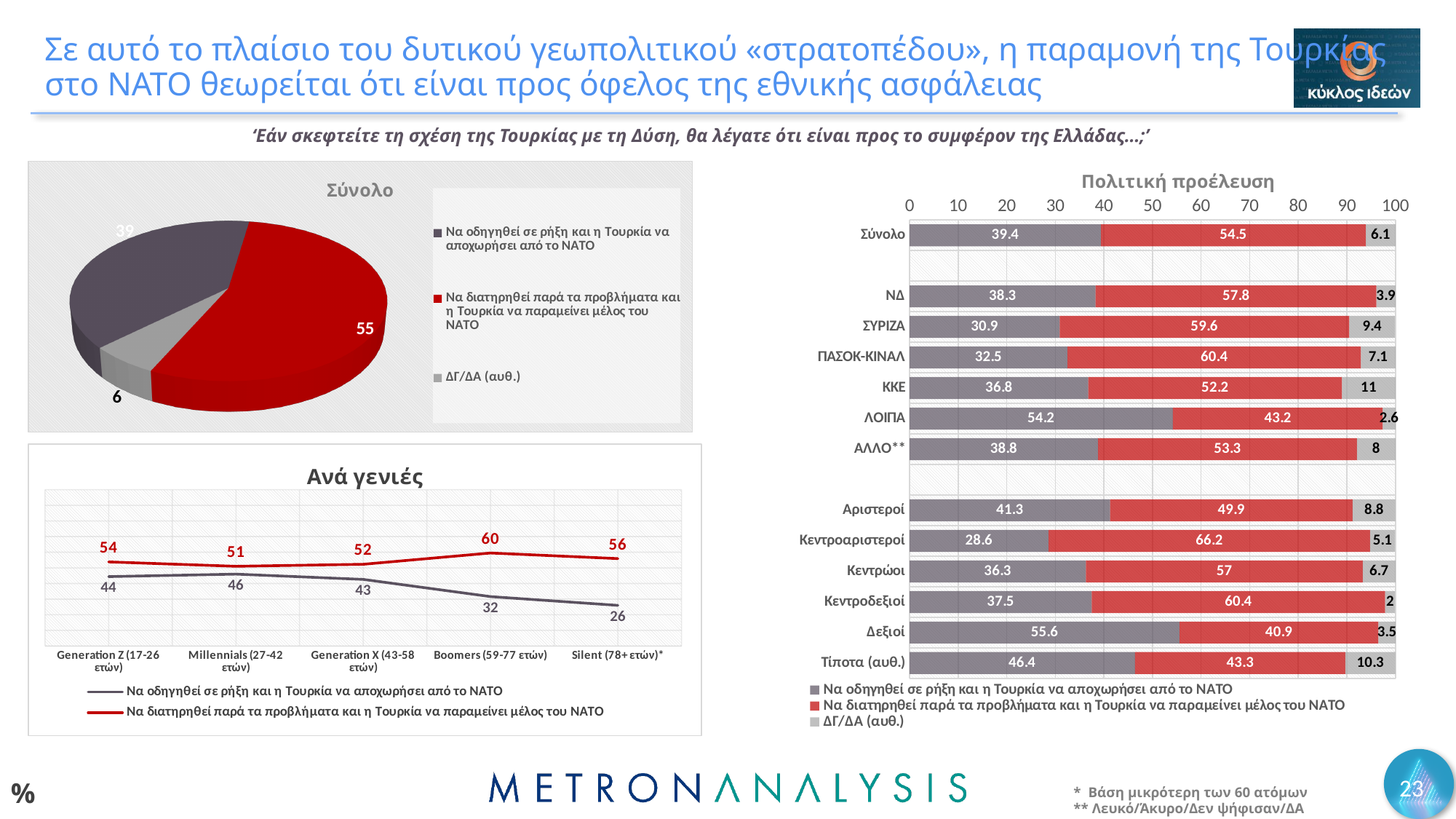
In the 'Πολιτική προέλευση' bar chart, which category has the lowest 'ΔΓ/ΔΑ (αυθ.)' value? Κεντροδεξιοί What kind of chart is the 'Σύνολο' chart on the left of the slide? pie chart In the 'Πολιτική προέλευση' bar chart, what is the value for ΣΥΡΙΖΑ in the 'Να διατηρηθεί παρά τα προβλήματα...' series? 59.6 How many series does the legend of the 'Πολιτική προέλευση' bar chart list? 3 In the 'Σύνολο' pie chart, what share does 'Να διατηρηθεί παρά τα προβλήματα και η Τουρκία να παραμείνει μέλος του ΝΑΤΟ' have? 55 In the 'Ανά γενιές' line chart, which generation has the lowest value for 'Να οδηγηθεί σε ρήξη και η Τουρκία να αποχωρήσει από το ΝΑΤΟ'? Silent (78+ ετών)* In the 'Ανά γενιές' line chart, what is the value of the red series for Boomers (59-77 ετών)? 60 In the 'Πολιτική προέλευση' bar chart, what is the total of the ΚΚΕ bar? 100 In the 'Πολιτική προέλευση' bar chart, which category has the highest value for 'Να οδηγηθεί σε ρήξη και η Τουρκία να αποχωρήσει από το ΝΑΤΟ'? Δεξιοί How many generation categories are shown on the x axis of the 'Ανά γενιές' chart? 5 In the 'Ανά γενιές' line chart, for Generation Z (17-26 ετών), which series has the larger value: the red or the grey line? the red line (54) In the 'Πολιτική προέλευση' bar chart, what is the difference between the red and grey values for ΝΔ? 19.5